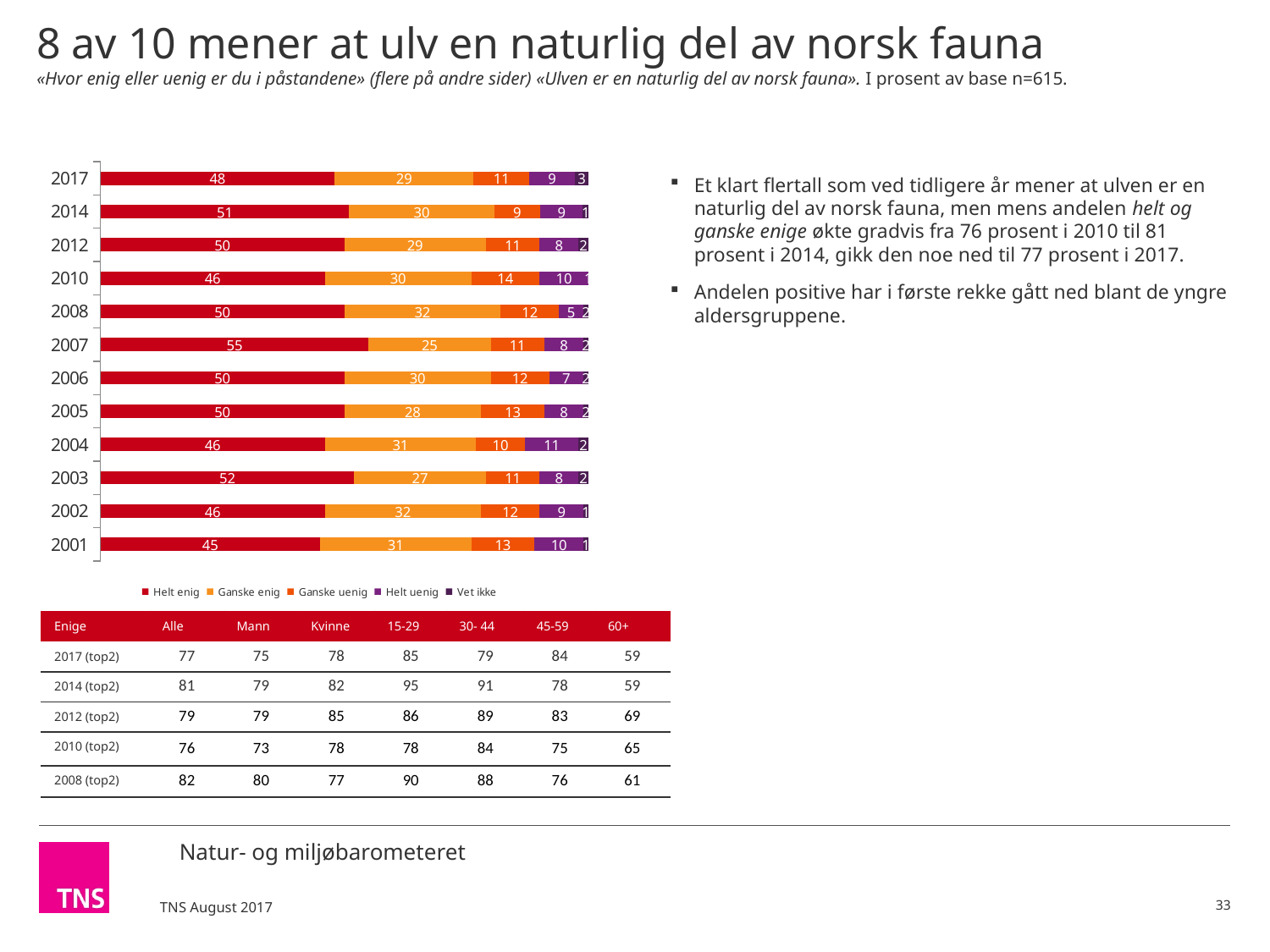
What is the value for 'Helt uenig' in 2004? 11 What is the value for 'Helt enig' in 2017? 48 Which is larger, the 'Ganske uenig' value for 2010 or for 2014? 2010 What is the difference between the 'Helt enig' values for 2014 and 2017? 3 Which year has the highest value for 'Helt enig'? 2007 What is the total of the stacked bar for 2017? 100 What kind of chart is shown on the slide? stacked bar chart How many years are shown as categories in the chart? 12 How many series does the chart legend list? 5 What is the value for 'Ganske enig' in 2010? 30 Which series is shown in red in the chart? Helt enig Which year has the lowest value for 'Helt enig'? 2001